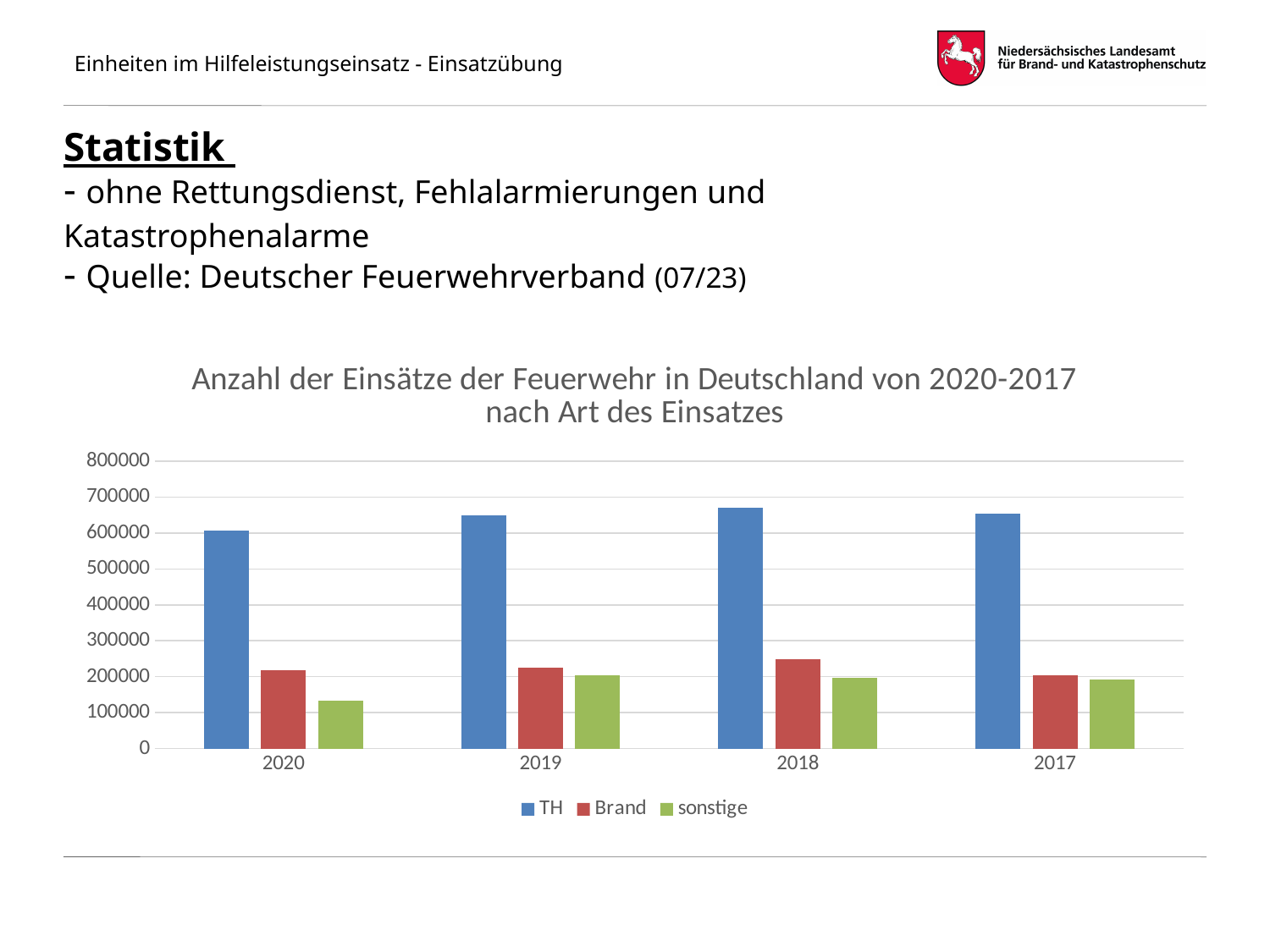
Is the value for Brand in 2018 greater or less than 200000? greater Is the value for TH in 2020 greater or less than 500000? greater What are the three series listed in the chart legend? TH, Brand, sonstige How many series does the chart legend list? 3 In 2020, which is larger: the value for Brand or the value for sonstige? Brand What is the title of the chart? Anzahl der Einsätze der Feuerwehr in Deutschland von 2020-2017 nach Art des Einsatzes Is the value for TH in 2018 greater or less than 700000? less In which year is the Brand value the highest? 2018 What kind of chart is shown on the slide? bar chart How many years are shown on the x axis of the chart? 4 In which year is the TH value the lowest? 2020